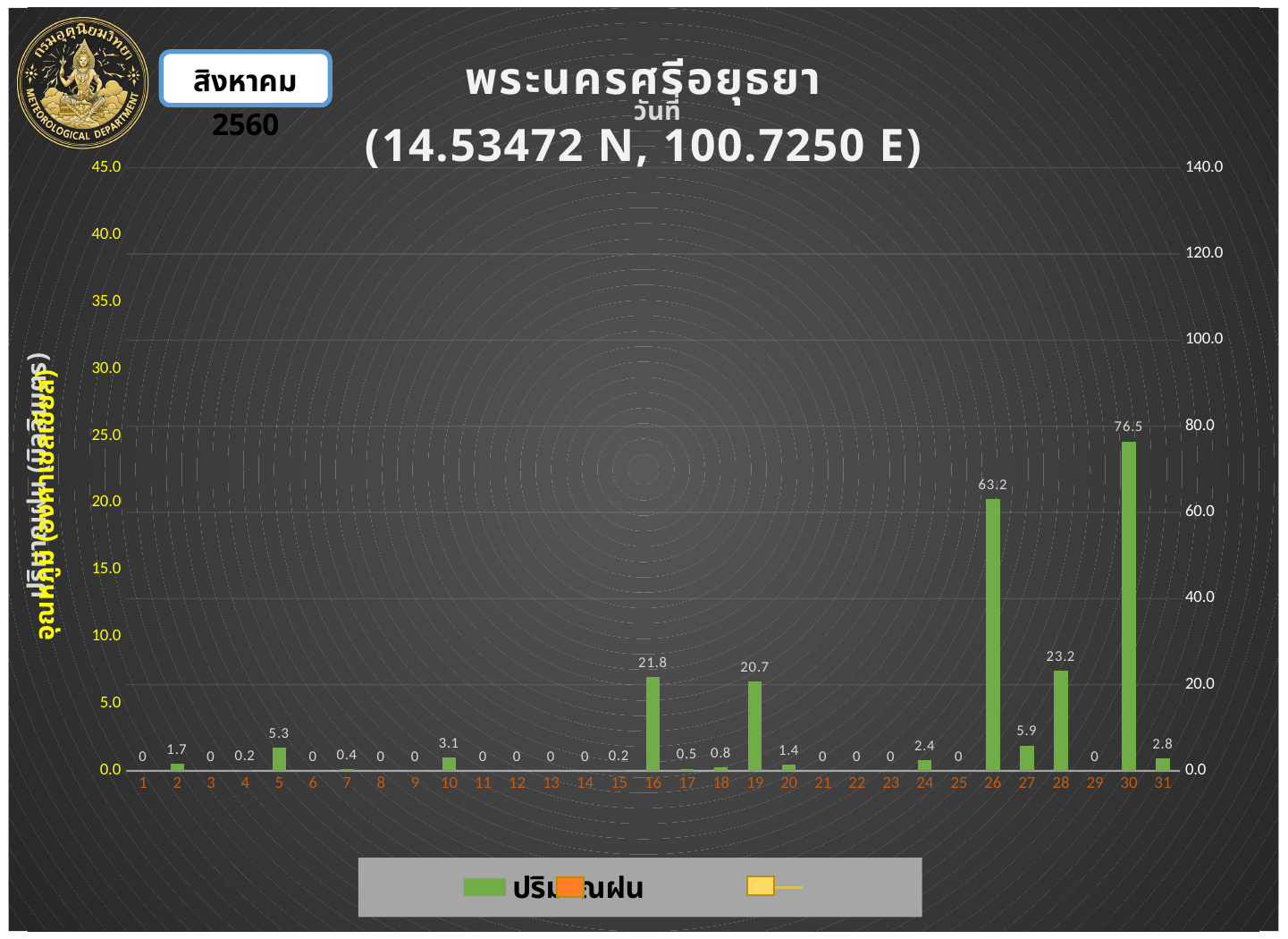
Which has a larger rainfall value, day 27 or day 10? day 27 What kind of chart is shown on the slide? bar chart What is the rainfall value shown for day 5? 5.3 What is the rainfall value shown for day 26? 63.2 Which has a larger rainfall value, day 16 or day 19? day 16 What is the rainfall value shown for day 16? 21.8 What is the rainfall value shown for day 30? 76.5 How many days are shown on the x axis? 31 What is the difference between the rainfall values for day 28 and day 19? 2.5 What colour are the rainfall (ปริมาณฝน) bars? green What is the difference between the rainfall values for day 30 and day 26? 13.3 Which day has the highest rainfall value? 30